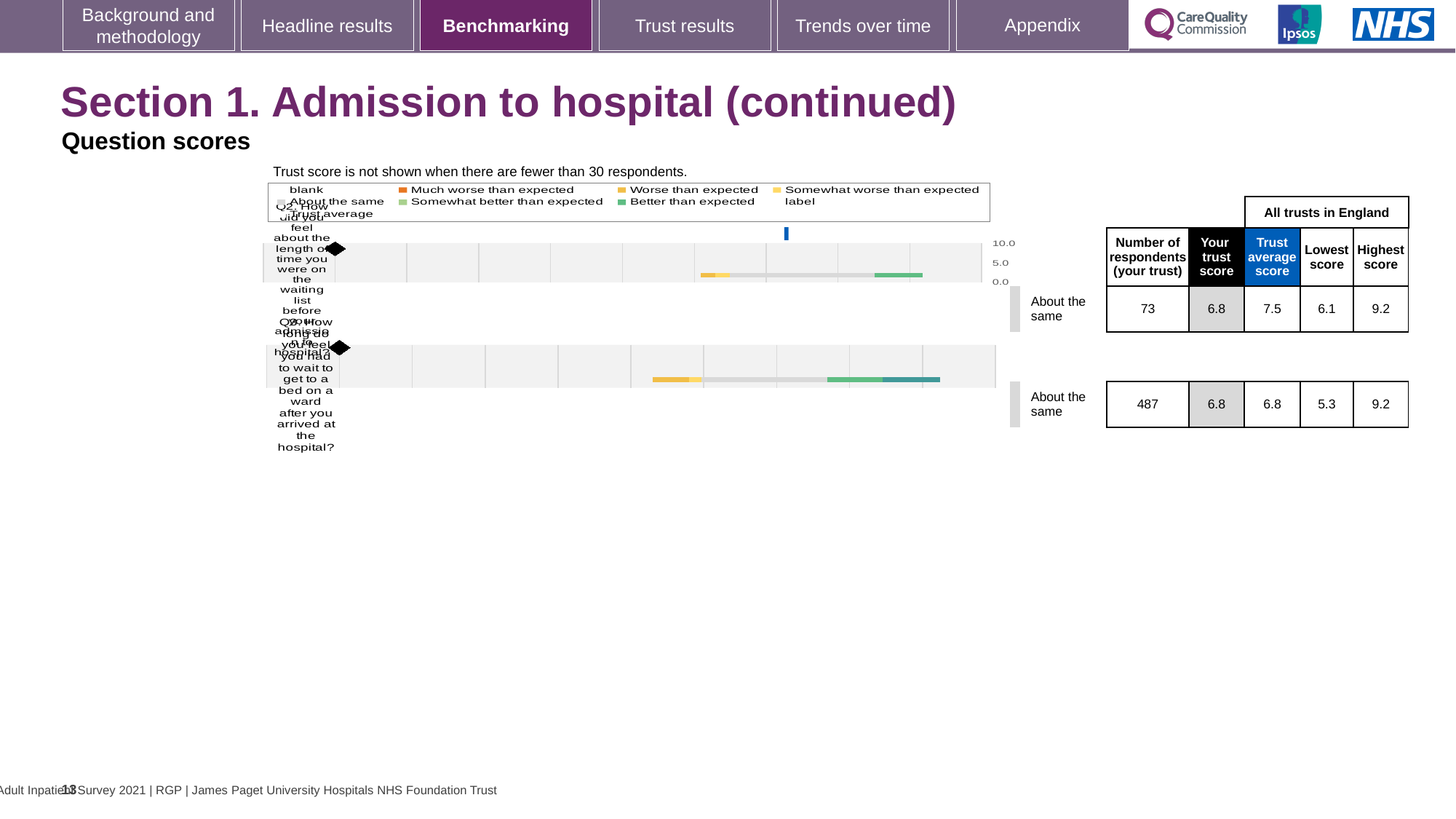
What is the lowest score across all trusts in England for Q3? 5.3 By how much does the trust average score for Q2 exceed the trust's own score for Q2? 0.7 How many respondents answered Q3 (how long did you feel you had to wait to get to a bed on a ward)? 487 How many questions are plotted on this slide? 2 What is the highest score across all trusts in England for Q2? 9.2 What is the difference between the highest and lowest scores for Q3? 3.9 What benchmark category is shown for Q3? About the same What is the trust average score for Q2? 7.5 Which question had more respondents, Q2 or Q3? Q3 What kind of chart is used to show the question scores? Bar chart Which question has the higher trust average score, Q2 or Q3? Q2 What is the 'Your trust score' for Q2 (how did you feel about the length of time on the waiting list before admission)? 6.8